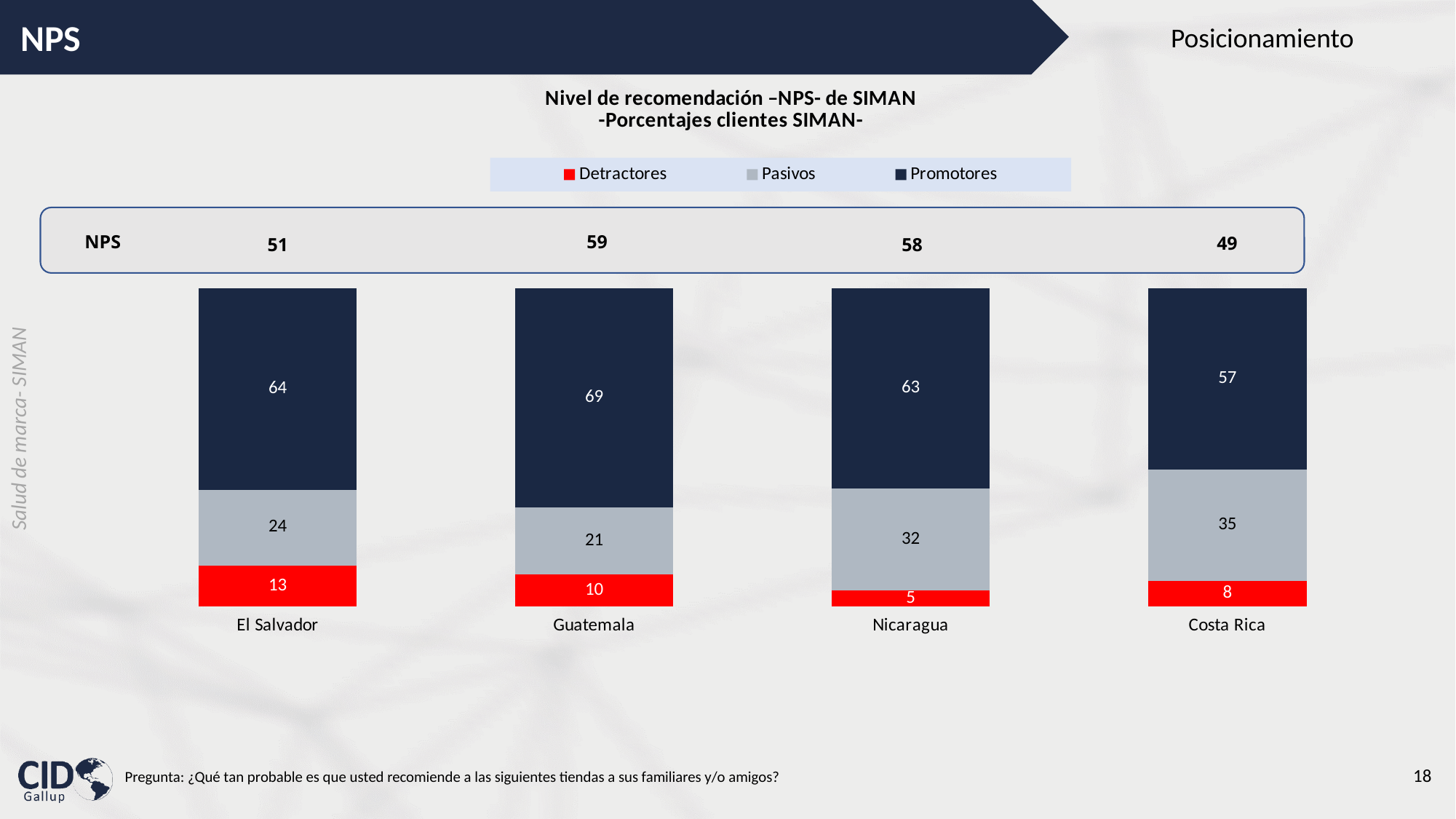
Which colour represents Detractores in the legend? Red Which country has the lowest Detractores value? Nicaragua Which country has the highest Promotores value? Guatemala Which is larger, the Pasivos value for Costa Rica or for El Salvador? Costa Rica What is the difference between the Promotores values for El Salvador and Costa Rica? 7 How many countries are shown on the x axis? 4 How many series does the legend list? 3 What is the Pasivos value for Nicaragua? 32 What is the Detractores value for Costa Rica? 8 What kind of chart is shown? Stacked bar chart What is the Promotores value for Guatemala? 69 What is the total of the stacked bar for Nicaragua? 100